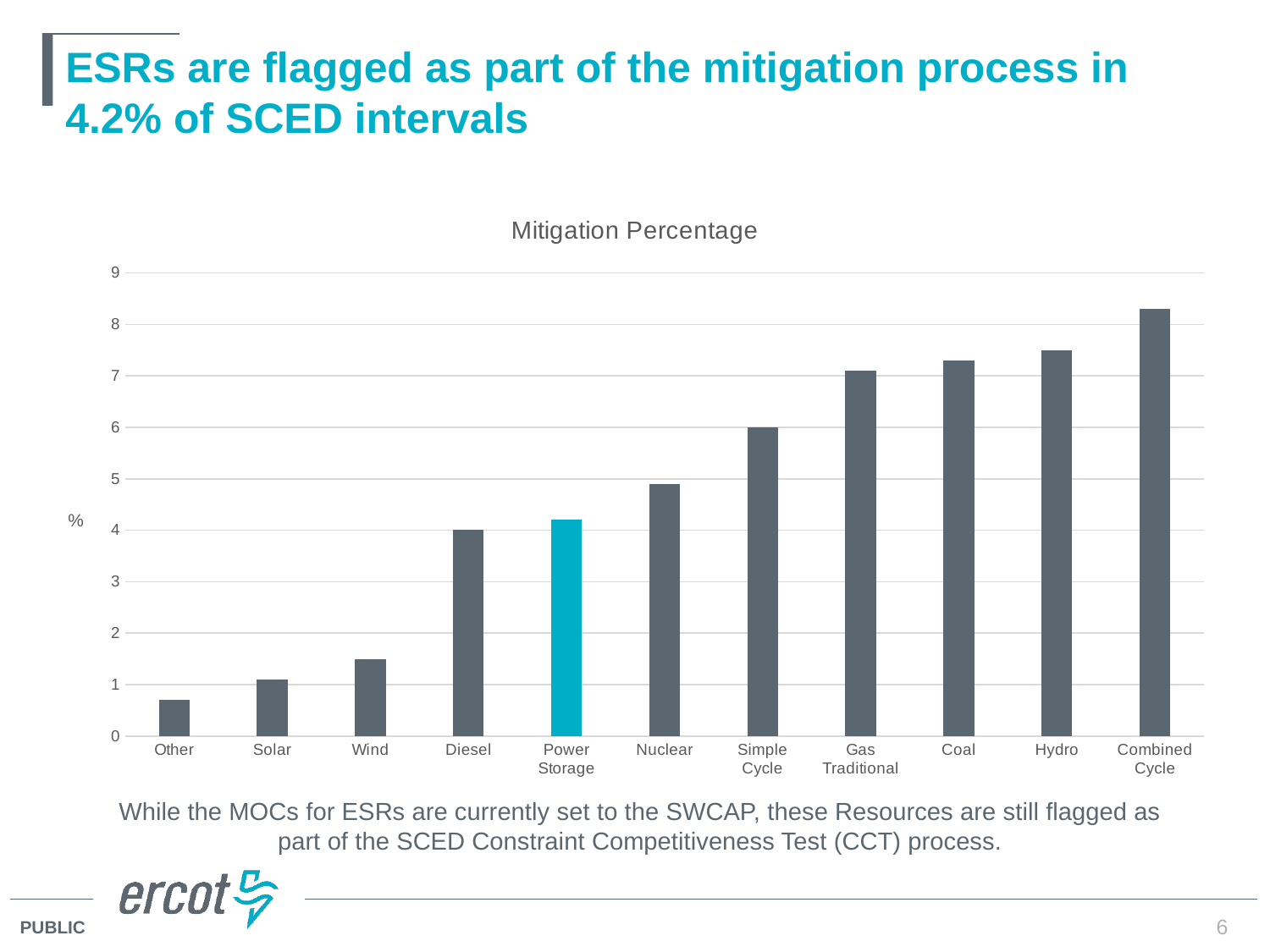
Do the values generally rise or fall moving from left to right along the x axis? Rise Which category has the lowest mitigation percentage? Other What type of chart is shown on the slide? Bar chart Is the value for Wind greater or less than 2? less What is the title of the chart? Mitigation Percentage Is the value for Combined Cycle greater or less than 8? greater How many categories are shown on the x axis of the chart? 11 Which category has the highest mitigation percentage? Combined Cycle What is the mitigation percentage for Power Storage? 4.2% What is the mitigation percentage for Diesel? 4 What is the mitigation percentage for Simple Cycle? 6 Which has a higher mitigation percentage, Nuclear or Diesel? Nuclear